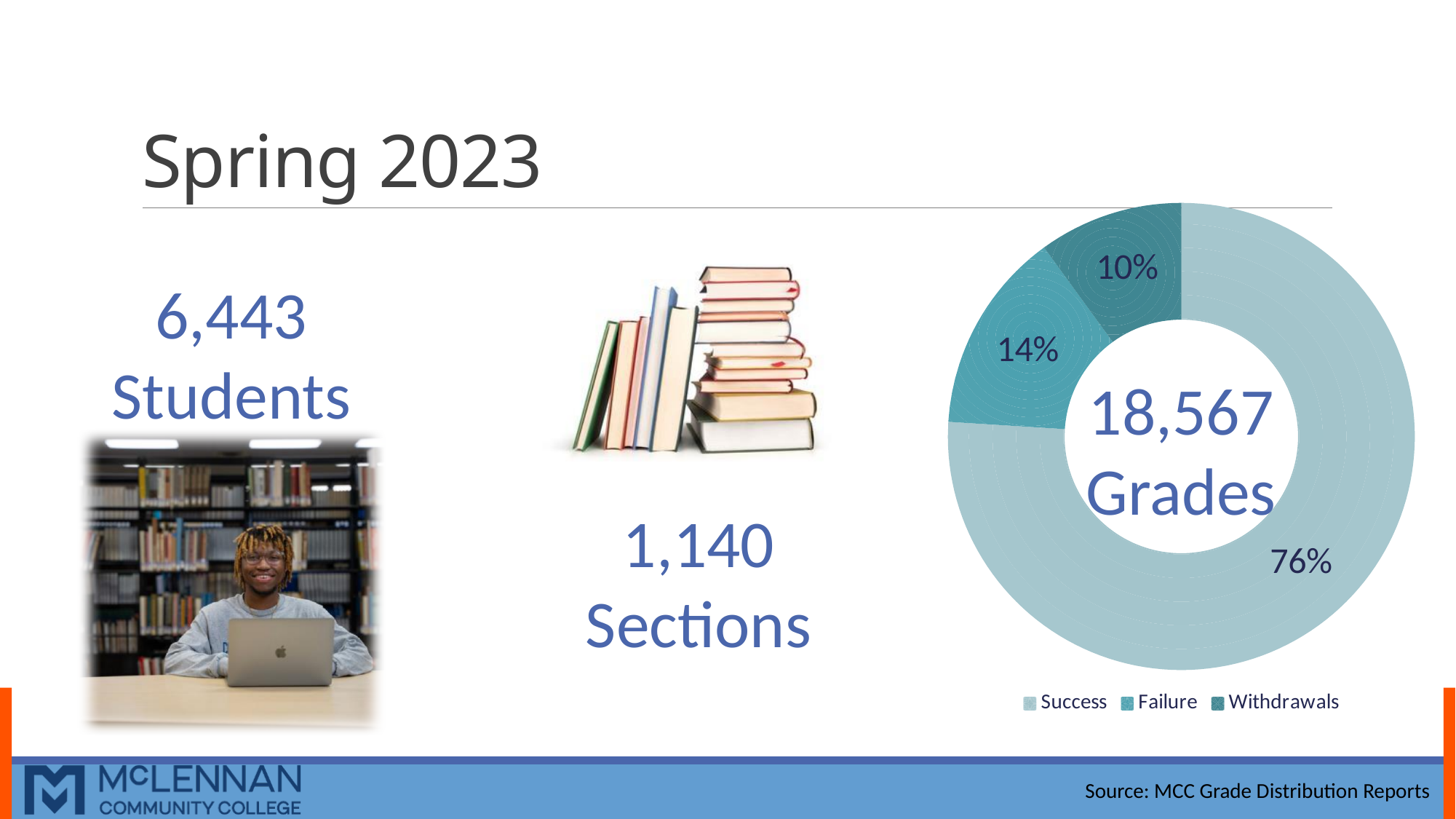
What percentage of grades were Failure? 14% What is the difference in percentage points between Failure and Withdrawals? 4 What kind of chart is shown on the slide? Doughnut (pie) chart What percentage of grades were Success? 76% What total number of grades is shown in the centre of the chart? 18,567 What percentage of grades were Withdrawals? 10% Which is larger, the Failure share or the Withdrawals share? Failure Which category has the smallest share of grades? Withdrawals Which category has the largest share of grades? Success What is the difference in percentage points between Success and Failure? 62 How many categories does the legend list? 3 What is the source cited for the chart data? MCC Grade Distribution Reports